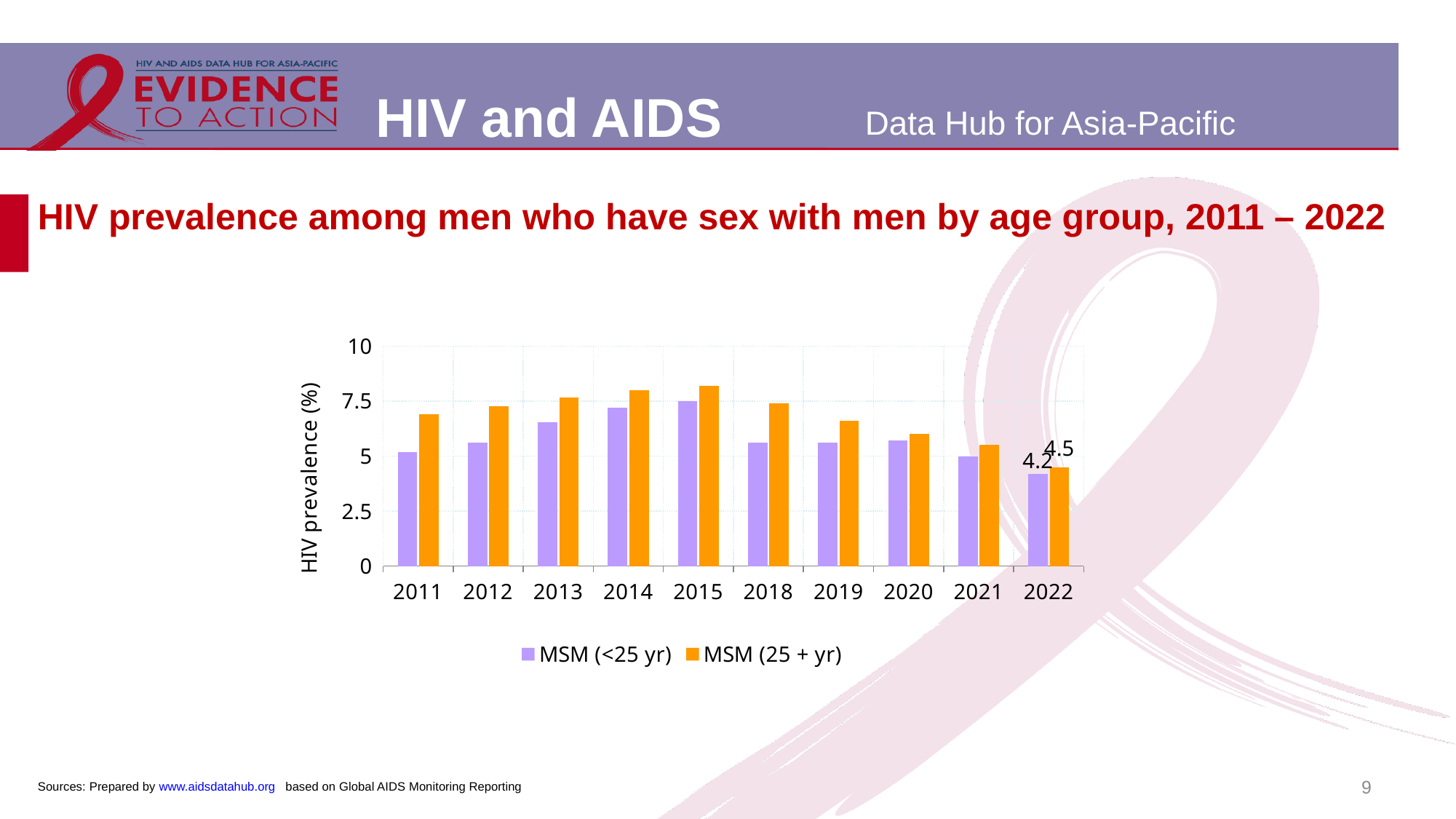
Is the value for MSM (25 + yr) in 2014 greater or less than 7.5? greater How many years are shown on the x axis of the chart? 10 What is the difference between the MSM (25 + yr) and MSM (<25 yr) values in 2022? 0.3 What is the HIV prevalence for MSM (<25 yr) in 2022? 4.2 How many series does the legend list? 2 What is the HIV prevalence for MSM (25 + yr) in 2022? 4.5 What kind of chart is shown on the slide? Bar chart In 2022, which group has the higher HIV prevalence, MSM (<25 yr) or MSM (25 + yr)? MSM (25 + yr) What is the label on the vertical axis of the chart? HIV prevalence (%) In which year is the HIV prevalence for MSM (<25 yr) lowest? 2022 In which year is the HIV prevalence for MSM (25 + yr) lowest? 2022 Is the value for MSM (25 + yr) in 2019 greater or less than 7.5? less